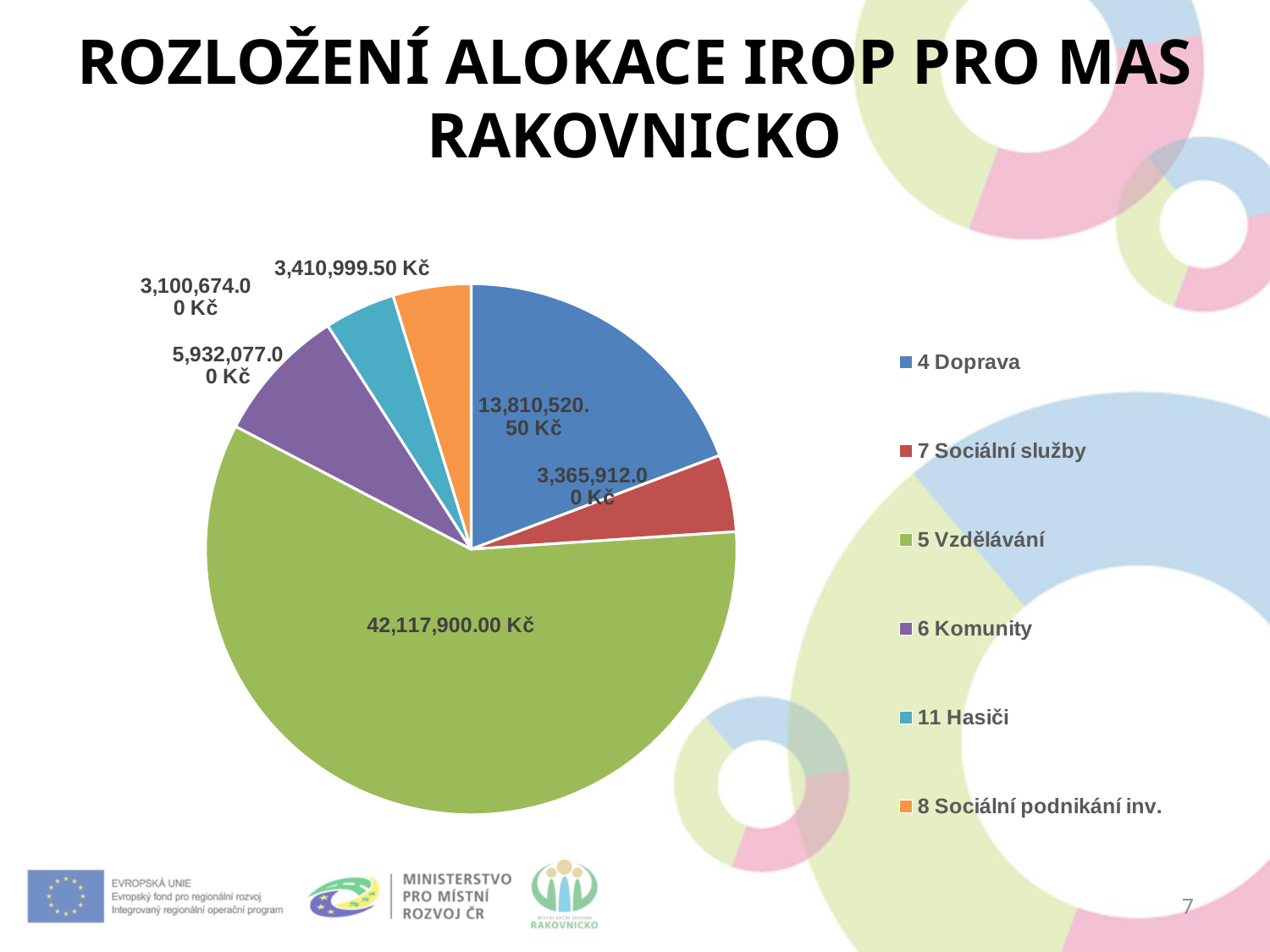
What is the value for 8 Sociální podnikání inv.? 3,410,999.50 Kč What is the value for 6 Komunity? 5,932,077.00 Kč What type of chart is shown on the slide? Pie chart What is the difference between the values for 4 Doprava and 7 Sociální služby? 10,444,608.50 Kč What is the difference between the values for 5 Vzdělávání and 4 Doprava? 28,307,379.50 Kč What is the value for 5 Vzdělávání? 42,117,900.00 Kč Which is larger, the value for 6 Komunity or the value for 7 Sociální služby? 6 Komunity Which category has the smallest allocation? 11 Hasiči Which category has the largest allocation? 5 Vzdělávání How many slices does the pie chart have? 6 What is the value for 4 Doprava? 13,810,520.50 Kč Which colour represents 11 Hasiči in the legend? Light blue (teal)